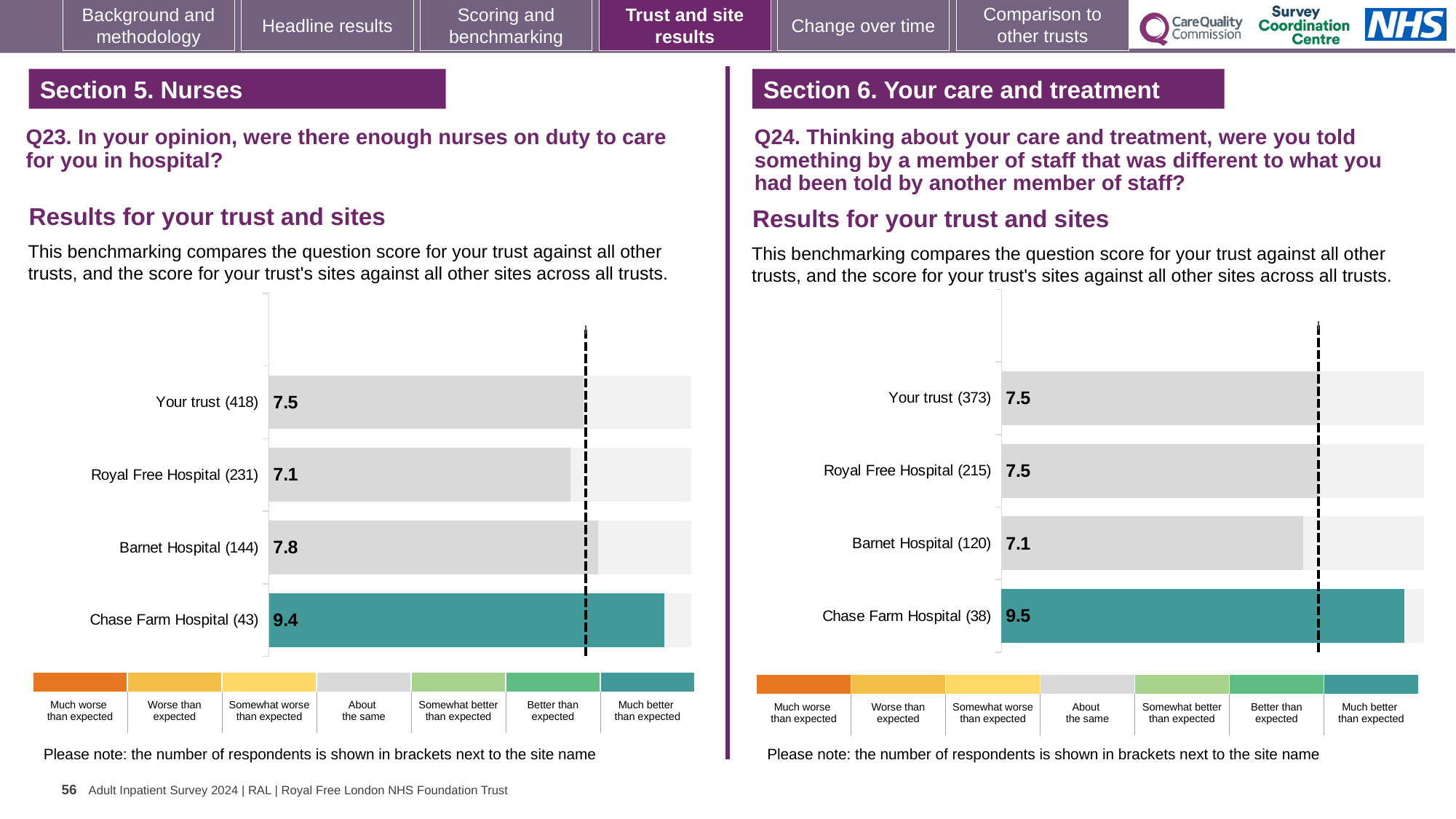
In the Q23 chart on the left, which site or trust has the lowest score? Royal Free Hospital In the Q24 chart on the right, what is the difference between the scores for Chase Farm Hospital and Barnet Hospital? 2.4 In the Q23 chart on the left, which site or trust has the highest score? Chase Farm Hospital In the Q23 chart on the left, what is the difference between the scores for Barnet Hospital and Royal Free Hospital? 0.7 In the Q24 chart on the right, which site or trust has the highest score? Chase Farm Hospital In the Q24 chart on the right, what is the score for Barnet Hospital? 7.1 In the Q23 chart on the left, what is the score for Royal Free Hospital? 7.1 In the Q23 chart on the left, what is the score for Chase Farm Hospital? 9.4 In the Q24 chart on the right, is the score for Chase Farm Hospital larger or smaller than the score for Royal Free Hospital? larger How many bars are plotted in the Q23 chart on the left? 4 What type of chart is used for the Q24 results on the right? Bar chart In the Q24 chart on the right, what is the score for Your trust? 7.5